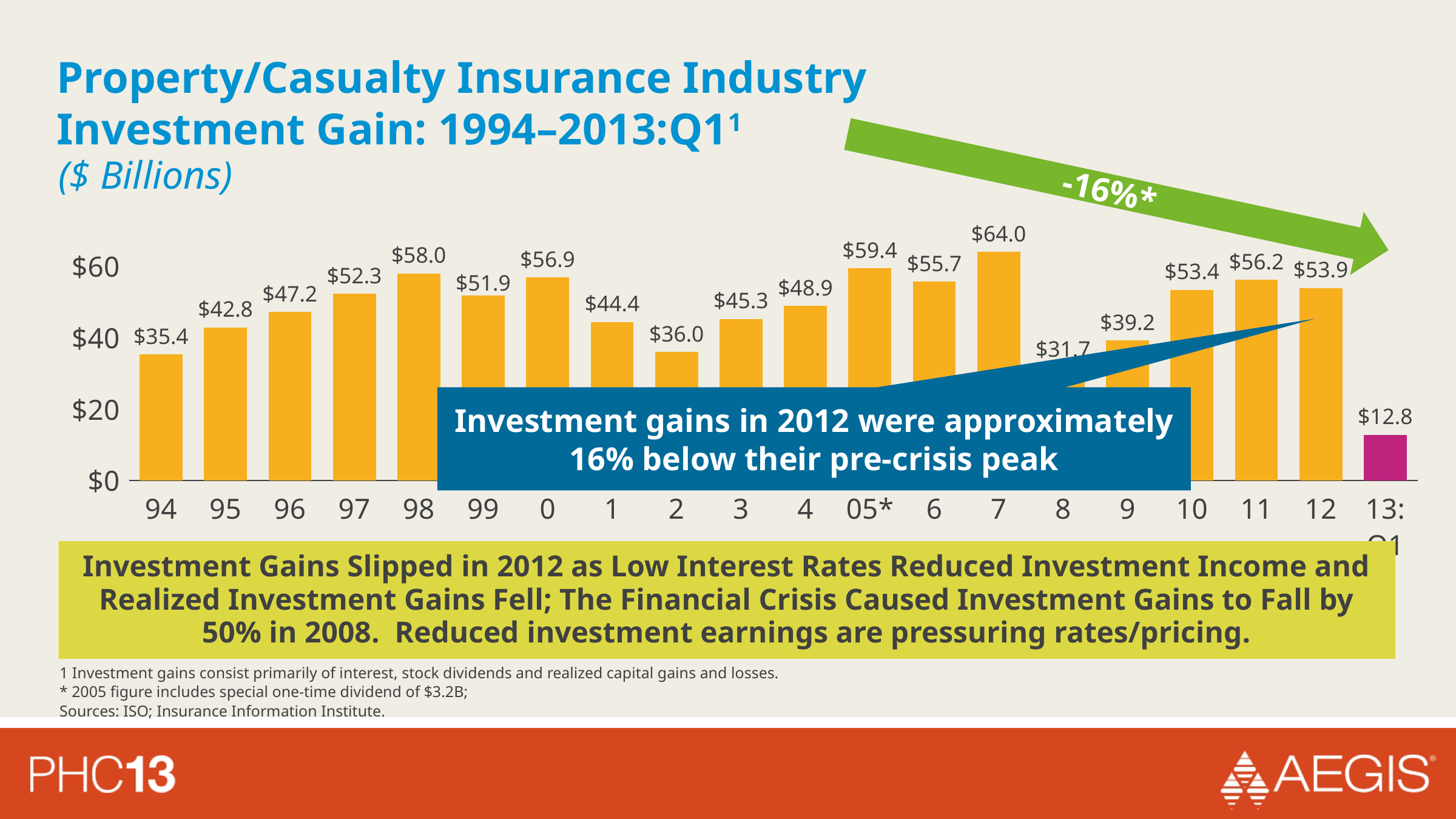
What is the difference between the 2007 value and the 2012 value? $10.1 What kind of chart is shown on the slide? Bar chart What was the investment gain in 2008? $31.7 What value is shown for 13:Q1? $12.8 Do the values rise or fall from 2008 to 2011? Rise How many bars are plotted on the chart? 20 What was the investment gain in 2007? $64.0 What is the difference between the 2007 value and the 2008 value? $32.3 Which year has the highest investment gain on the chart? 2007 Which is larger, the value for 1998 or the value for 1999? 1998 Is the value for 2009 greater or less than $40? less Which full year (excluding 13:Q1) has the lowest investment gain? 2008